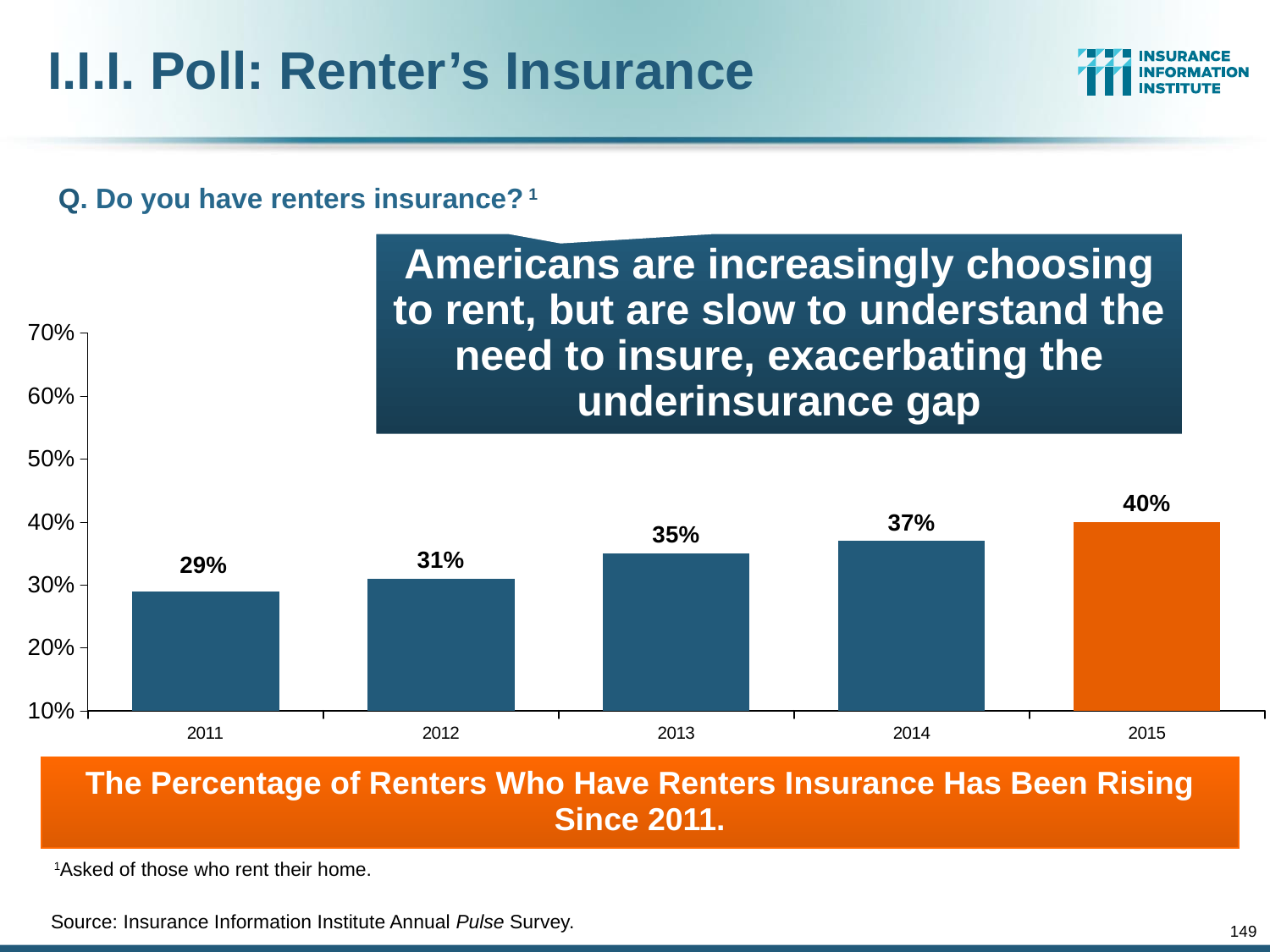
What is the value shown for 2013? 35% Which year has a larger value, 2012 or 2014? 2014 Do the values rise or fall from 2011 to 2015? Rise What percentage of renters had renters insurance in 2011? 29% What is the value shown for 2015? 40% Which year has the lowest percentage of renters with renters insurance? 2011 What kind of chart is shown on the slide? Bar chart What is the difference between the 2014 and 2012 values? 6 percentage points What is the difference in percentage points between 2015 and 2011? 11 percentage points How many years are shown on the chart? 5 Is the value for 2013 greater or less than 30%? greater Which year has the highest percentage of renters with renters insurance? 2015